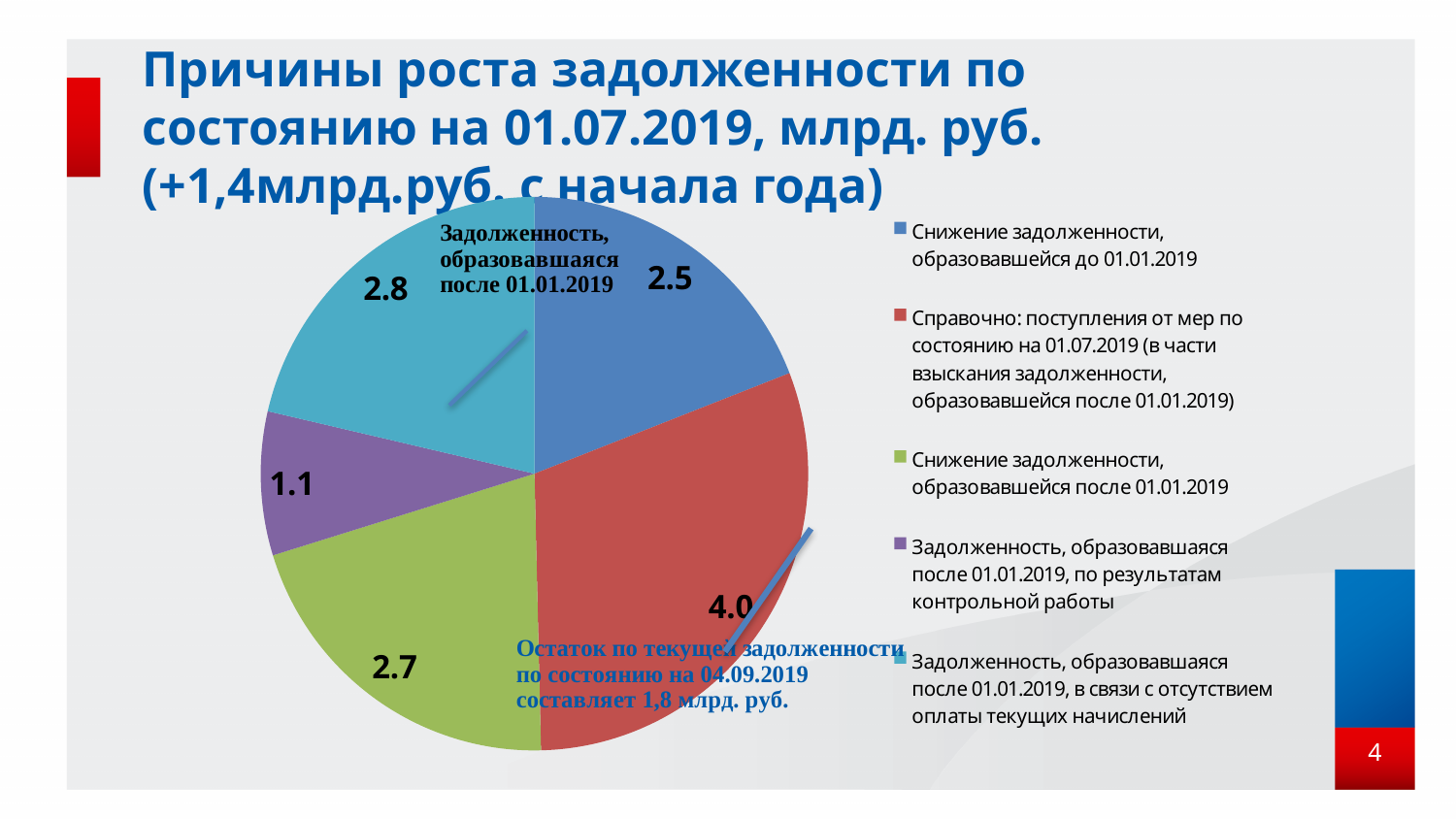
What is the value of the slice for "Задолженность, образовавшаяся после 01.01.2019, в связи с отсутствием оплаты текущих начислений"? 2.8 What is the value of the slice for "Снижение задолженности, образовавшейся до 01.01.2019"? 2.5 What is the value of the slice for "Справочно: поступления от мер по состоянию на 01.07.2019 (в части взыскания задолженности, образовавшейся после 01.01.2019)"? 4.0 Which slice of the pie chart has the smallest value? Задолженность, образовавшаяся после 01.01.2019, по результатам контрольной работы Which slice of the pie chart has the largest value? Справочно: поступления от мер по состоянию на 01.07.2019 (в части взыскания задолженности, образовавшейся после 01.01.2019) How many entries does the legend of the pie chart list? 5 What is the value of the slice for "Снижение задолженности, образовавшейся после 01.01.2019"? 2.7 What is the value of the slice for "Задолженность, образовавшаяся после 01.01.2019, по результатам контрольной работы"? 1.1 What kind of chart is shown on the slide? pie chart Which is larger: the slice for "Снижение задолженности, образовавшейся после 01.01.2019" or the slice for "Снижение задолженности, образовавшейся до 01.01.2019"? Снижение задолженности, образовавшейся после 01.01.2019 What is the difference between the largest slice (4.0) and the smallest slice (1.1)? 2.9 How many slices does the pie chart have? 5